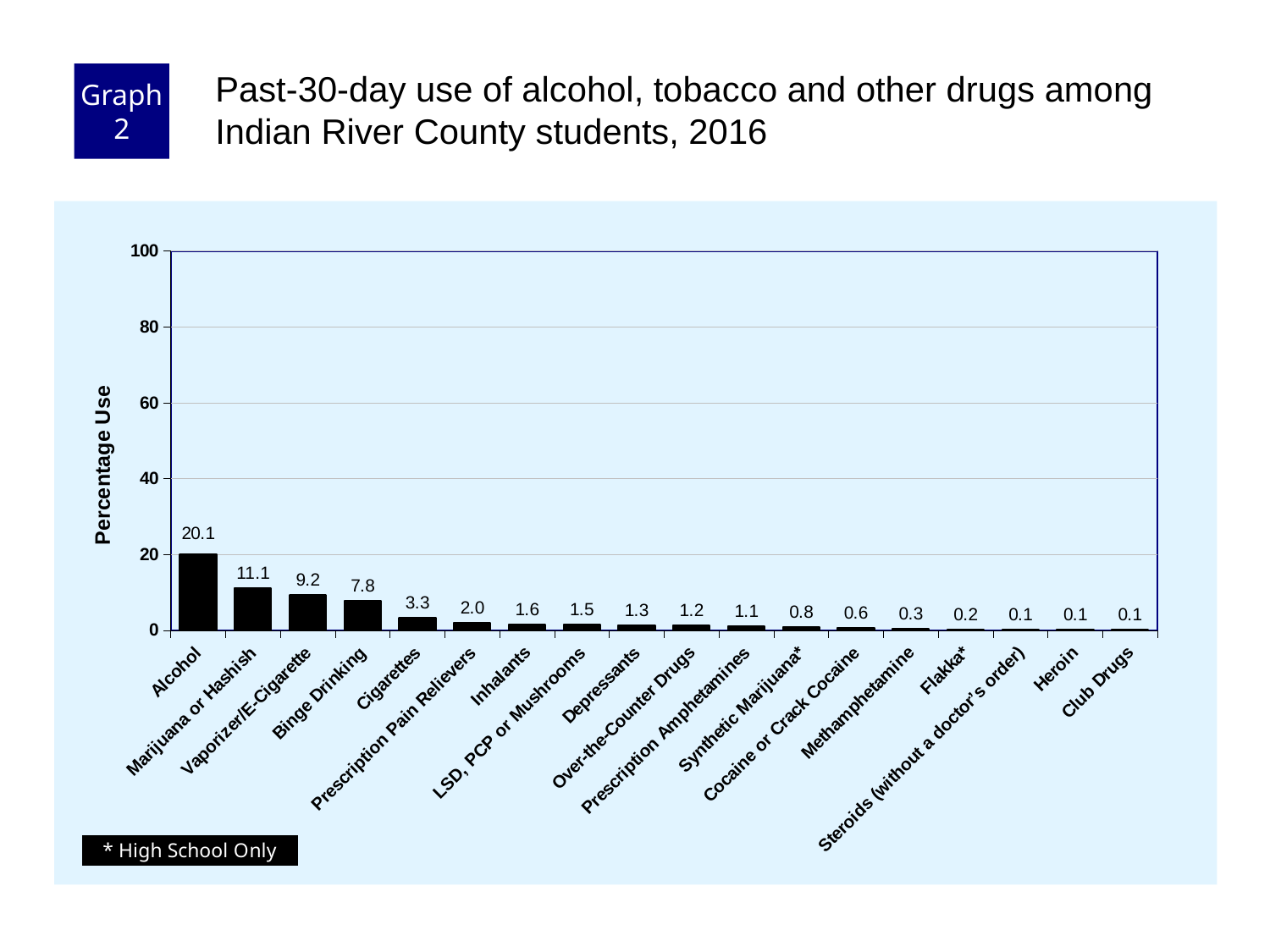
What value is shown for Marijuana or Hashish? 11.1 What kind of chart is shown on the slide? Bar chart What value is shown for Cigarettes? 3.3 What value is shown for Methamphetamine? 0.3 What value is shown for Vaporizer/E-Cigarette? 9.2 What is the label on the y axis? Percentage Use What is the past-30-day use percentage for Alcohol? 20.1 Is the value for Alcohol greater or less than 40? less Which is larger, the value for Inhalants or the value for Depressants? Inhalants What is the difference between the values for Alcohol and Binge Drinking? 12.3 Which category has the highest percentage use? Alcohol How many categories are shown on the x axis? 18